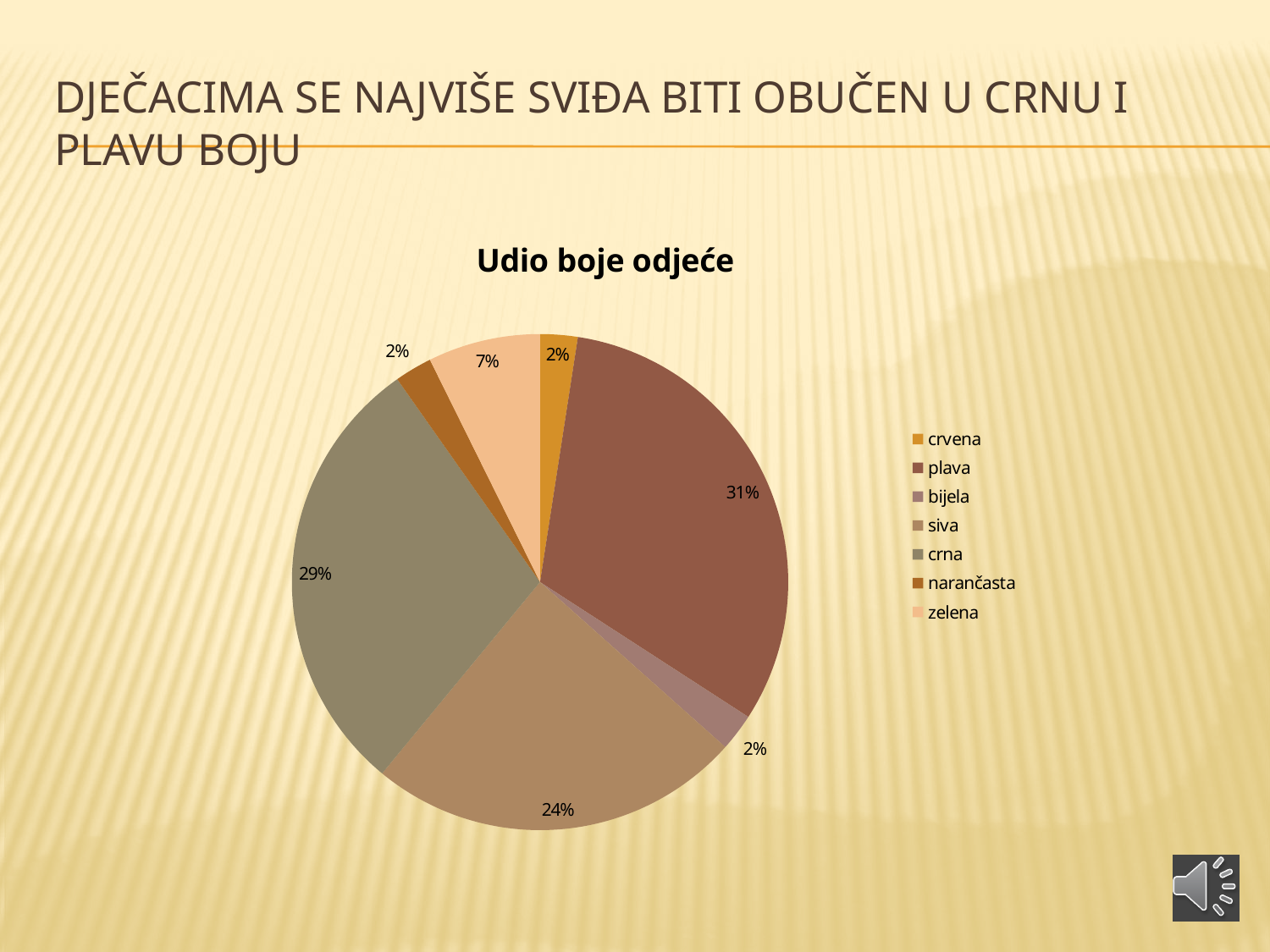
What share of the pie does siva have? 24% What is the difference in percentage points between plava and crna? 2 What share of the pie does zelena have? 7% How many categories does the legend list? 7 Which is larger, the share for siva or the share for zelena? siva What share of the pie does crna have? 29% What is the combined share of plava and crna? 60% What type of chart is shown on the slide? pie chart Which category has the largest share of the pie? plava What is the title of the chart? Udio boje odjeće